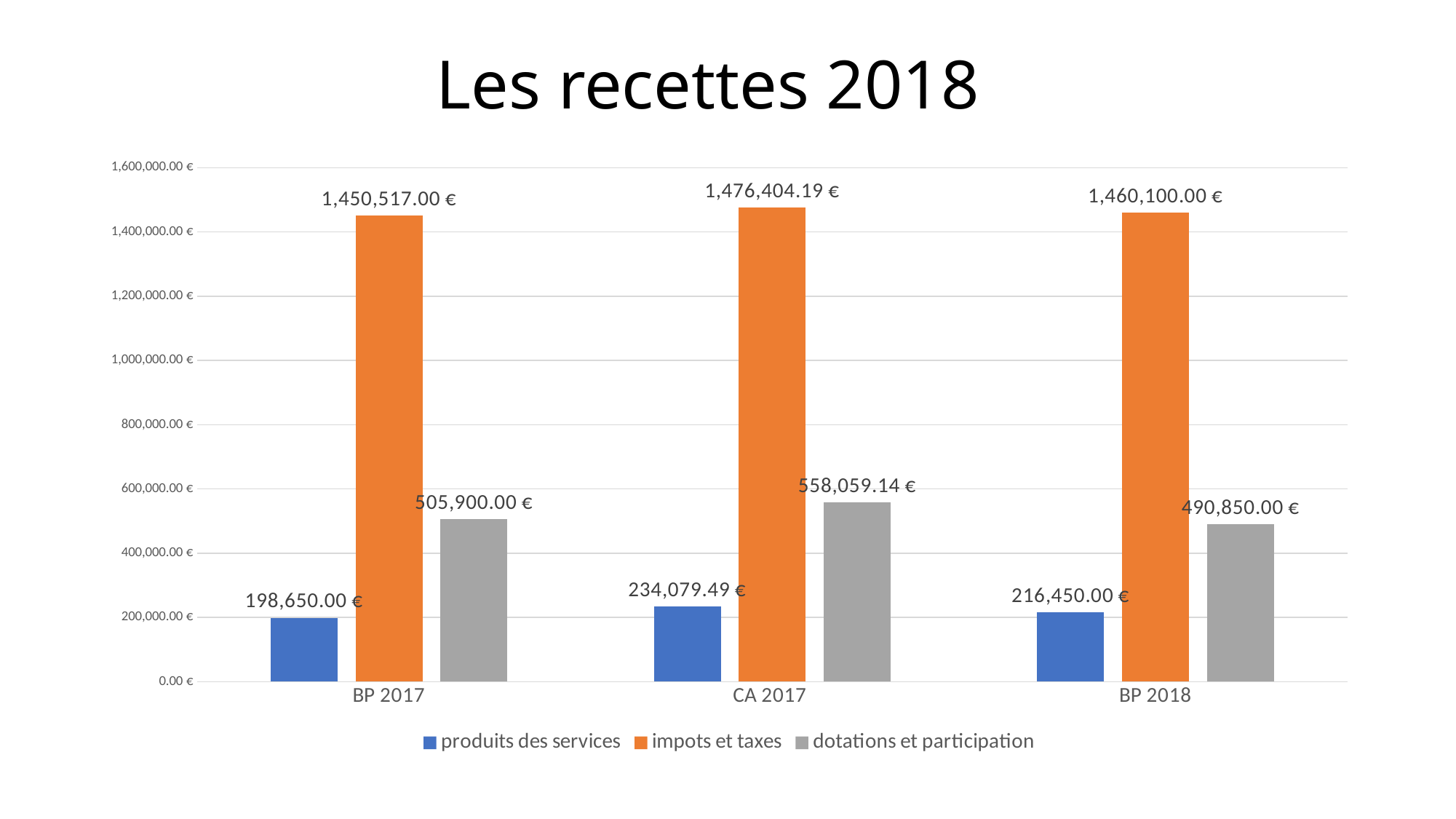
In which category is impots et taxes highest? CA 2017 What is the value for produits des services in BP 2018? 216,450.00 € Is the value for produits des services in CA 2017 greater or less than 200,000.00 €? greater Which is larger: dotations et participation in BP 2017 or in BP 2018? BP 2017 What kind of chart is shown on the slide? bar chart What is the difference between dotations et participation in CA 2017 and in BP 2018? 67,209.14 € What is the value for dotations et participation in BP 2017? 505,900.00 € What is the value for impots et taxes in CA 2017? 1,476,404.19 € How many categories are shown on the x axis? 3 In which category is produits des services lowest? BP 2017 What is the difference between impots et taxes in BP 2018 and in BP 2017? 9,583.00 € How many series does the legend list? 3